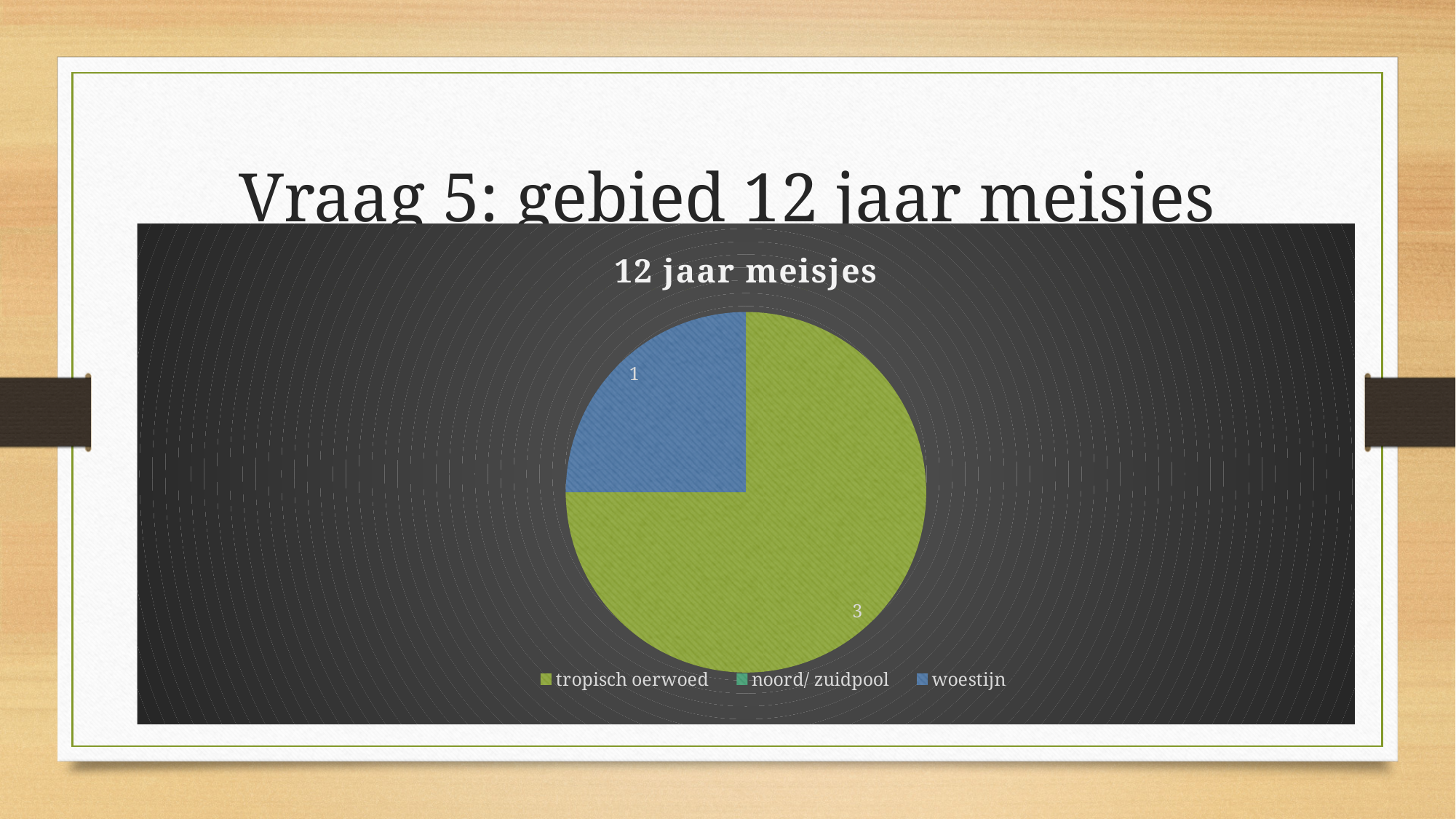
Which of the two visible slices is larger, tropisch oerwoed or woestijn? tropisch oerwoed What kind of chart is shown on the slide? pie chart How many entries does the chart legend list? 3 What share of the pie does woestijn represent? 25% What is the difference between the values for tropisch oerwoed and woestijn? 2 What is the total of the values shown on the pie chart? 4 What is the value for woestijn? 1 What is the value for tropisch oerwoed? 3 What is the title of the chart? 12 jaar meisjes What share of the pie does tropisch oerwoed represent? 75% Which legend entry is shown in blue? woestijn Which category has the largest slice of the pie? tropisch oerwoed